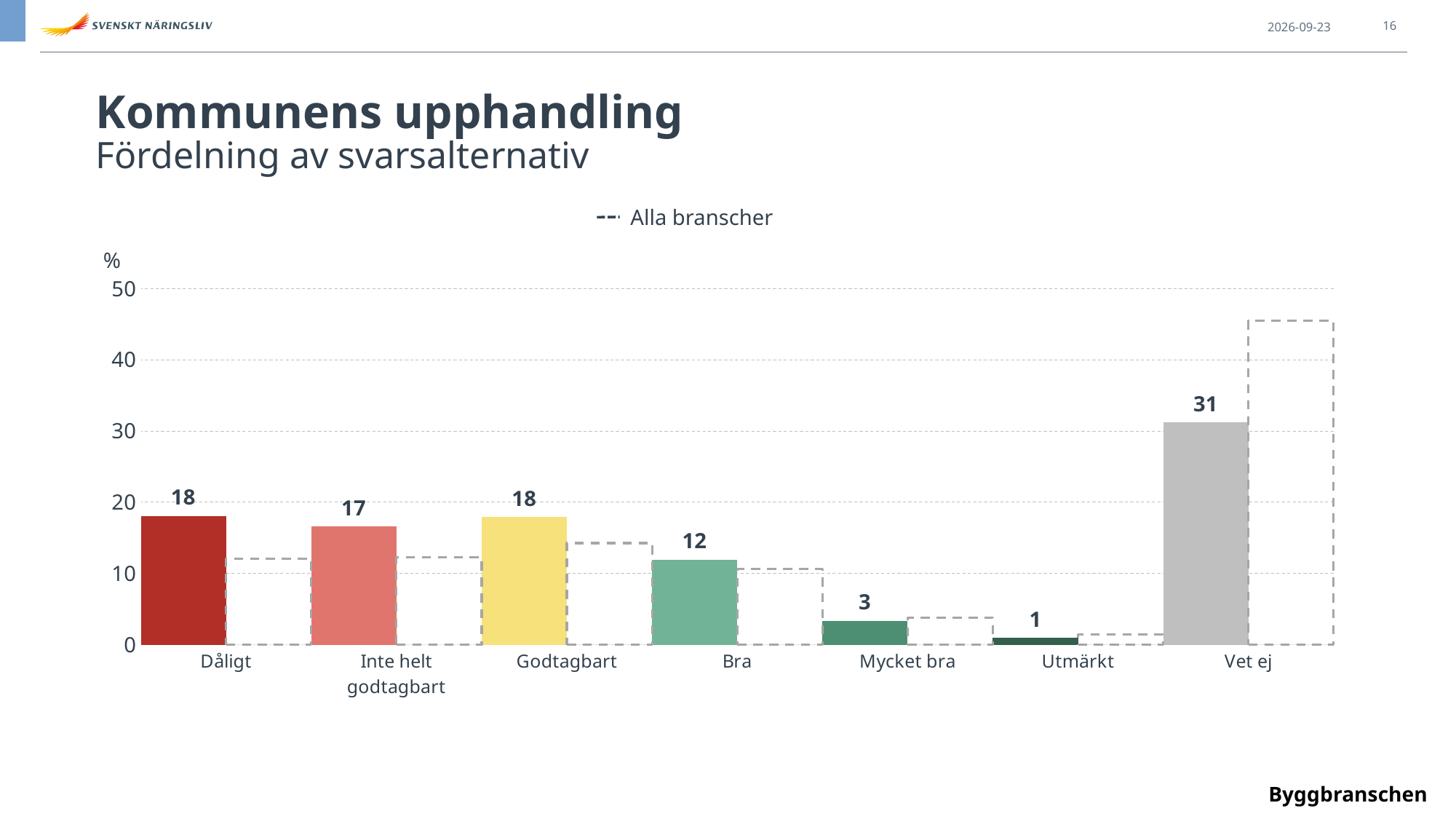
Which category has the highest value? Vet ej What kind of chart is shown on the slide? bar chart What is the value for Vet ej? 31 What is the value for Bra? 12 Which category has the lowest value? Utmärkt Which is larger, the value for Bra or the value for Mycket bra? Bra What is the value for Inte helt godtagbart? 17 What is the value for Mycket bra? 3 What is the legend entry shown above the chart? Alla branscher What is the difference between the values for Vet ej and Dåligt? 13 Is the dashed Alla branscher value for Vet ej greater or less than 40? greater How many categories are shown on the x axis? 7